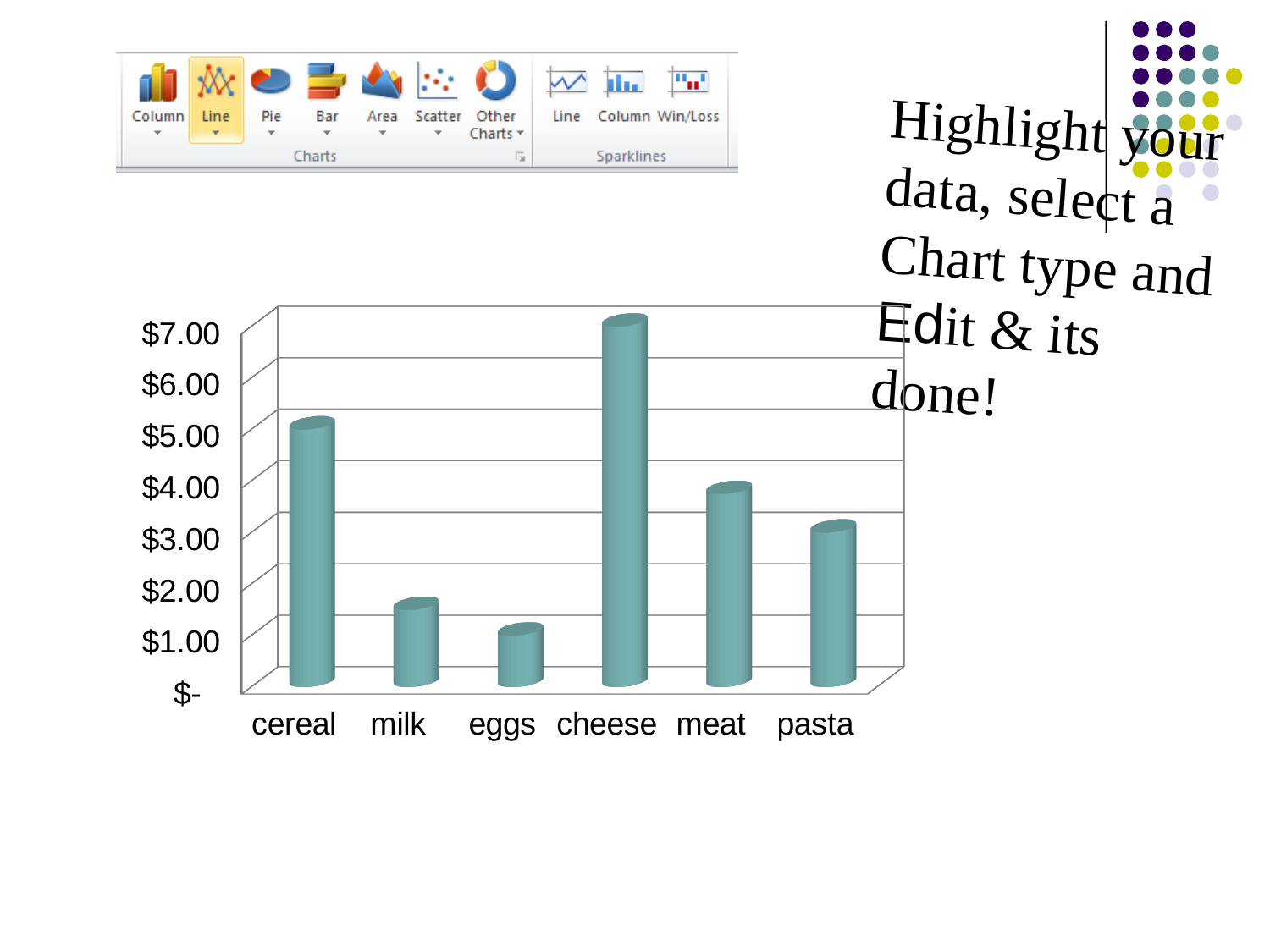
What is the highest tick label shown on the vertical axis of the chart? $7.00 Which has a larger value, milk or eggs? milk Is the value for milk greater or less than $2.00? less Which category has the lowest value in the chart? eggs Is the value for pasta greater or less than $4.00? less Is the value for cheese greater or less than $6.00? greater Which has a larger value, meat or pasta? meat How many categories are shown on the x axis of the chart? 6 Which category has the highest value in the chart? cheese What kind of chart is shown on the slide? bar chart